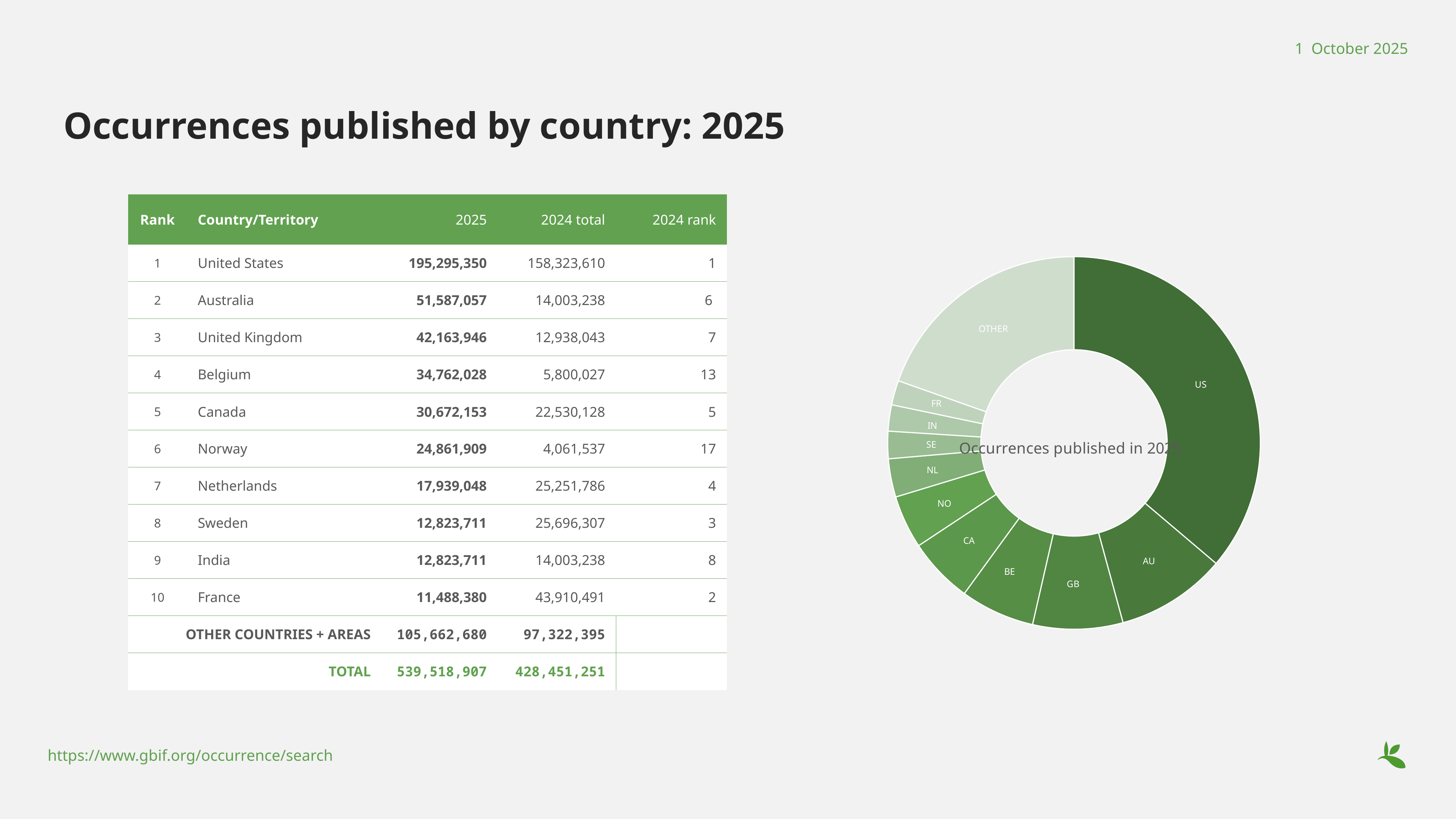
What is the 2025 value for the US slice of the donut chart, as printed in the table? 195,295,350 What is the difference between the US and AU 2025 values shown on the slide? 143,708,293 What kind of chart is shown on the right of the slide? pie chart (donut) How many slices does the donut chart have? 11 Which slice of the donut chart is the largest? US In the donut chart, which slice is larger, AU or GB? AU What is the total of all 2025 occurrences represented by the donut chart, as printed in the table? 539,518,907 Which labelled country slice of the donut chart is the smallest? FR What is the title shown in the centre of the donut chart? Occurrences published in 2025 In the donut chart, which slice is larger, NO or NL? NO What is the 2025 value for the BE slice of the donut chart, as printed in the table? 34,762,028 In the donut chart, which slice is larger, OTHER or US? US